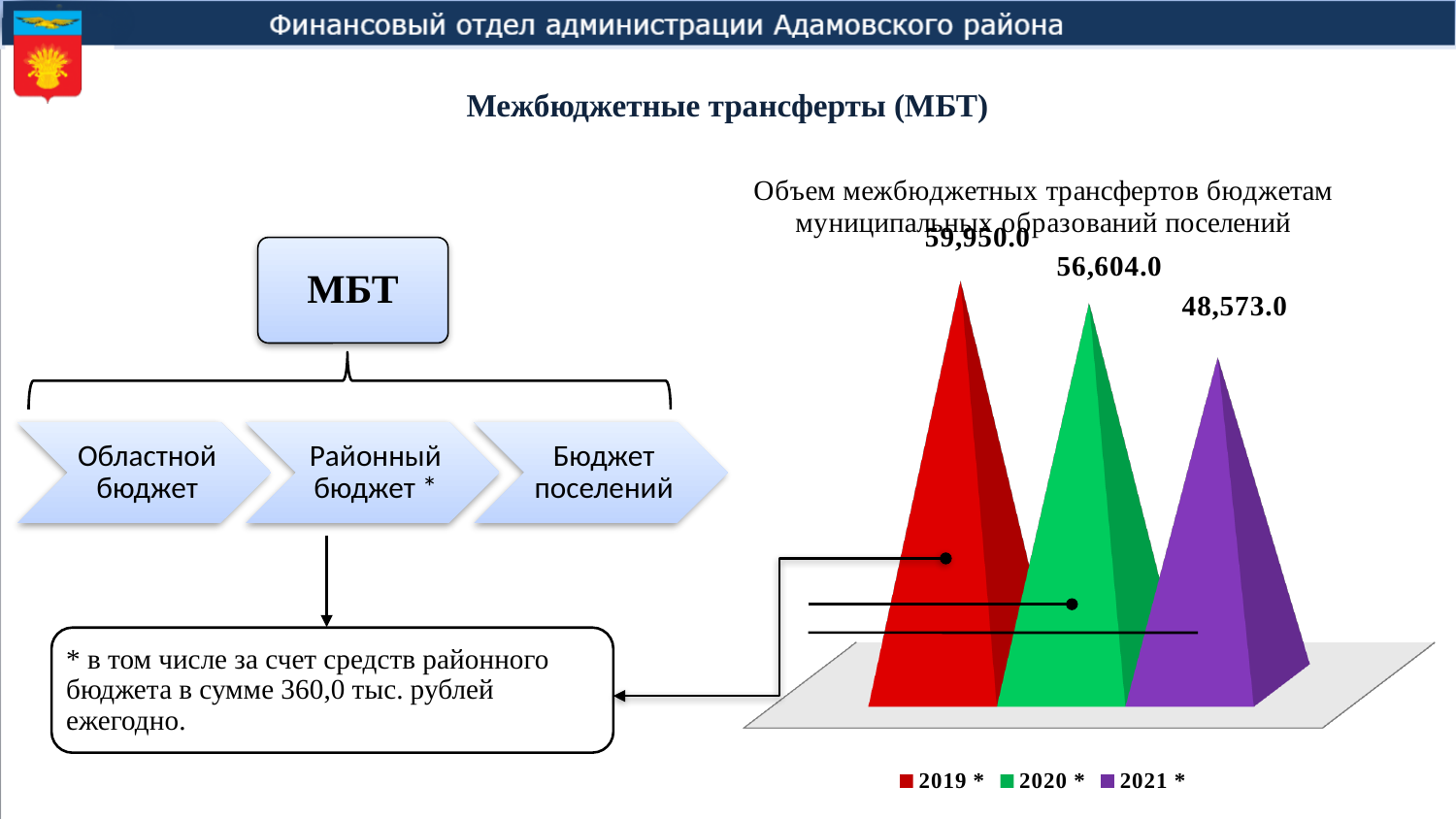
What is the difference between the values for 2019 * and 2020 *? 3,346.0 Which is larger, the value for 2020 * or the value for 2021 *? 2020 * What is the value shown for 2019 * in the chart? 59,950.0 How many series does the chart legend list? 3 What is the value shown for 2021 * in the chart? 48,573.0 Which year has the lowest value in the chart? 2021 * What is the value shown for 2020 * in the chart? 56,604.0 Which year has the highest value in the chart? 2019 * Do the values rise or fall from 2019 * to 2021 *? fall What colour represents 2021 * in the chart? purple What is the difference between the values for 2019 * and 2021 *? 11,377.0 What is the title of the chart? Объем межбюджетных трансфертов бюджетам муниципальных образований поселений